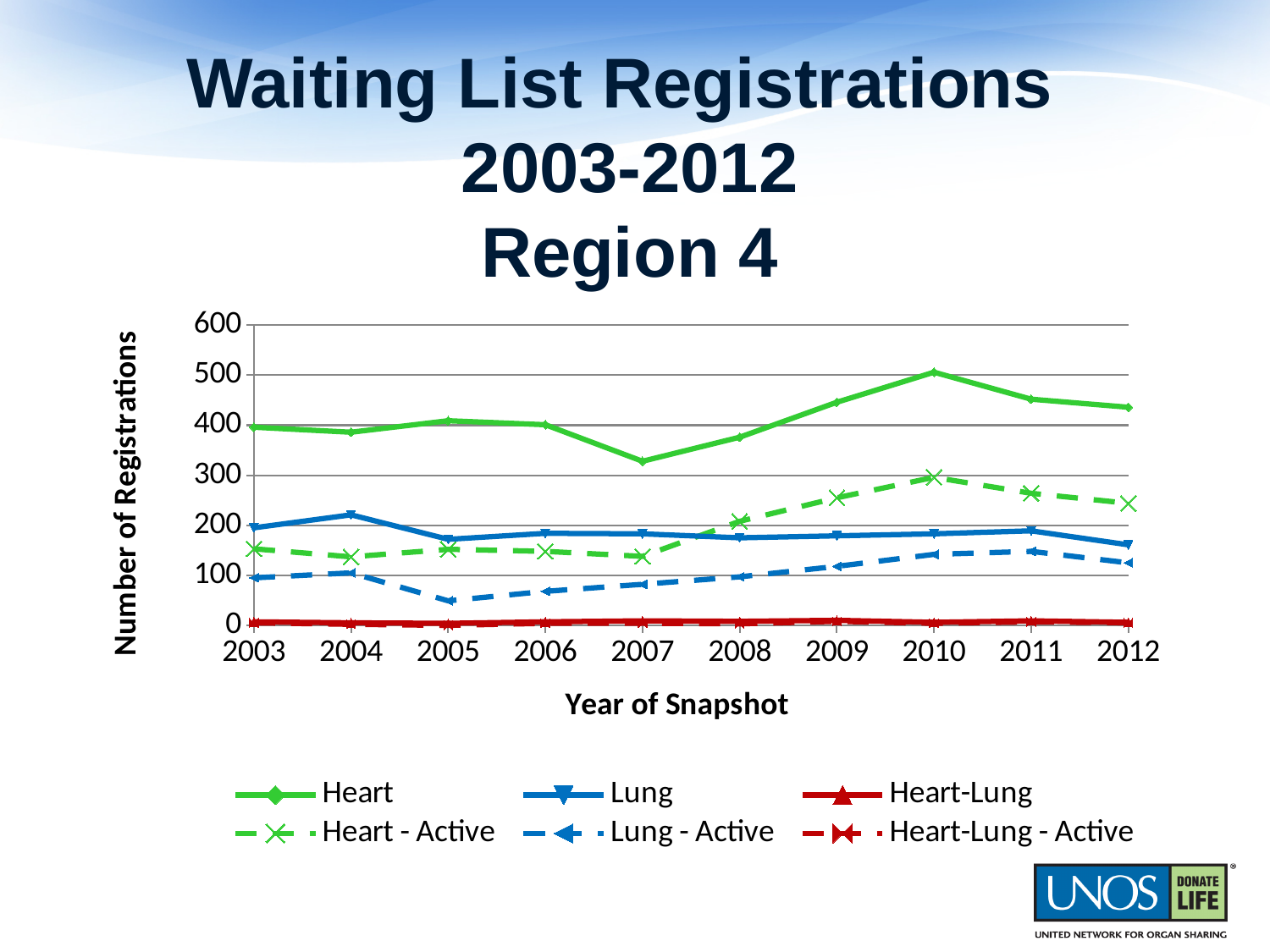
Is the value for Heart - Active in 2010 greater or less than 200? greater How many years are plotted along the x axis? 10 In which year is the Heart series at its lowest? 2007 Does the Heart - Active series rise or fall from 2007 to 2010? rise In which year is the Heart series at its highest? 2010 Which series has the larger value in 2010, Heart or Lung? Heart In which year is the Lung - Active series at its lowest? 2005 How many series does the legend list? 6 In which year is the Lung series at its highest? 2004 What is the title of the x axis? Year of Snapshot Is the value for Heart in 2007 greater or less than 400? less What kind of chart is shown on the slide? line chart